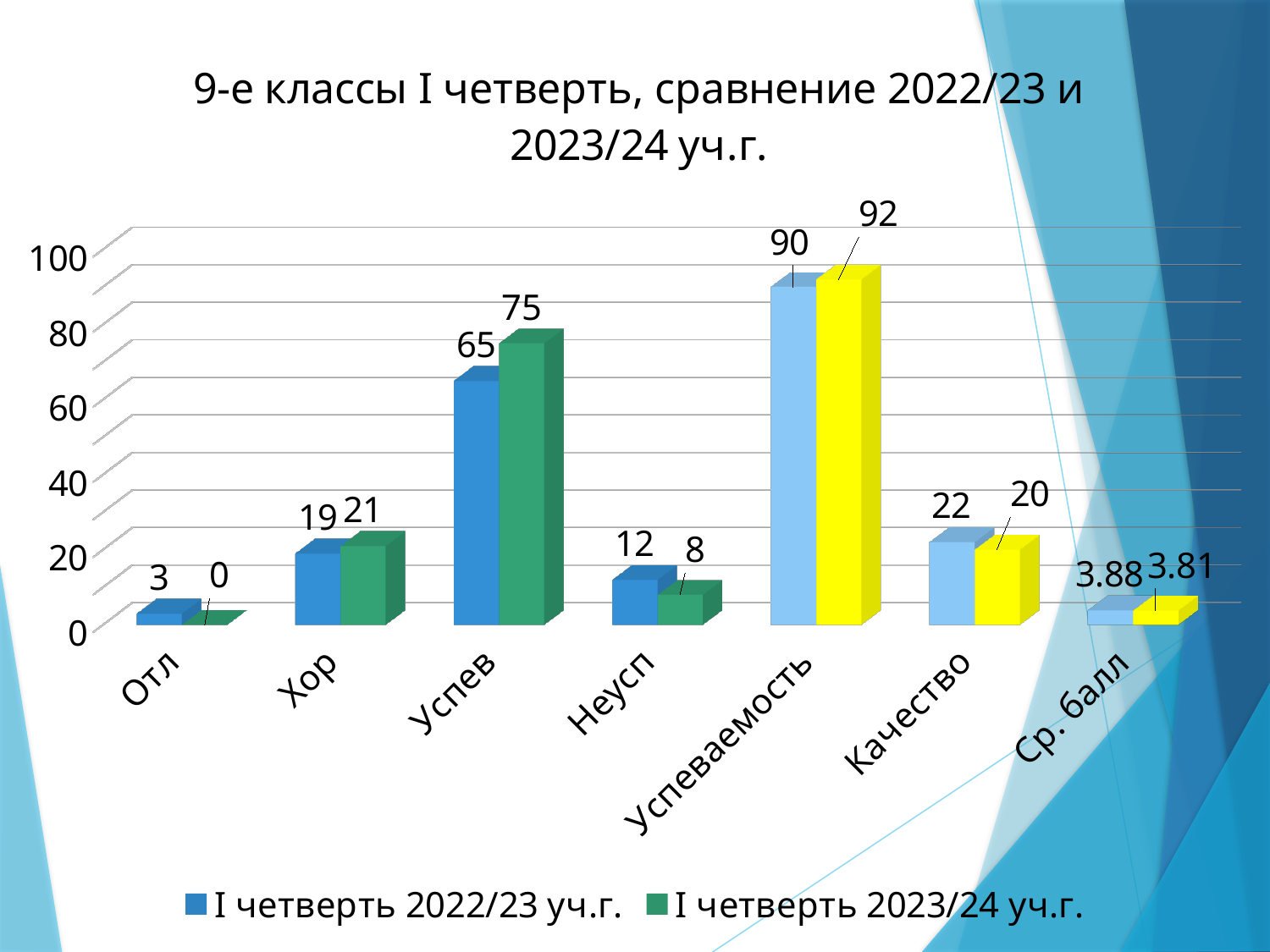
What is the value for Ср. балл in the I четверть 2023/24 уч.г. series? 3.81 What is the value for Успев in the I четверть 2023/24 уч.г. series? 75 What kind of chart is shown on the slide? Bar chart Which category has the lowest value in the I четверть 2023/24 уч.г. series? Отл Which is larger for Качество: the I четверть 2022/23 уч.г. value or the I четверть 2023/24 уч.г. value? I четверть 2022/23 уч.г. What is the title of the chart? 9-е классы I четверть, сравнение 2022/23 и 2023/24 уч.г. What is the value for Отл in the I четверть 2023/24 уч.г. series? 0 How many series does the legend list? 2 What is the difference between the I четверть 2023/24 уч.г. and I четверть 2022/23 уч.г. values for Успев? 10 What is the value for Неусп in the I четверть 2022/23 уч.г. series? 12 Which category has the highest value in the I четверть 2022/23 уч.г. series? Успеваемость How many categories are shown on the x axis? 7